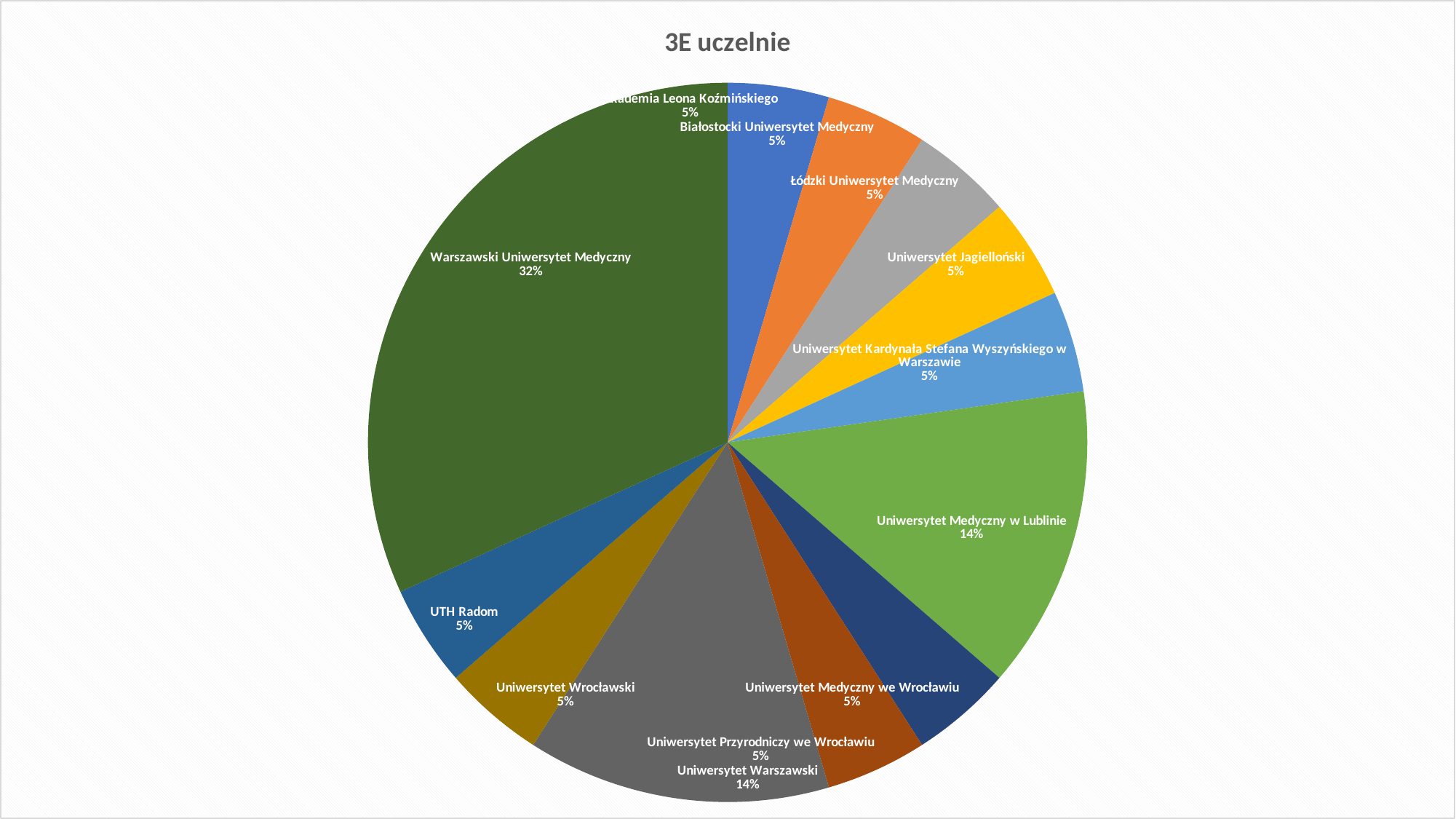
Which is larger, the share for Uniwersytet Medyczny w Lublinie or the share for Uniwersytet Wrocławski? Uniwersytet Medyczny w Lublinie What share of the pie does Uniwersytet Medyczny w Lublinie have? 14% Which university has the largest share of the pie? Warszawski Uniwersytet Medyczny What is the value shown for Uniwersytet Jagielloński? 5% What share of the pie does Uniwersytet Warszawski have? 14% What is the difference in percentage points between Warszawski Uniwersytet Medyczny and Uniwersytet Warszawski? 18 What is the title of the chart? 3E uczelnie What kind of chart is shown on the slide? pie chart What is the value shown for Uniwersytet Kardynała Stefana Wyszyńskiego w Warszawie? 5% How many slices does the pie chart have? 12 What is the value shown for UTH Radom? 5% What share of the pie does Warszawski Uniwersytet Medyczny have? 32%